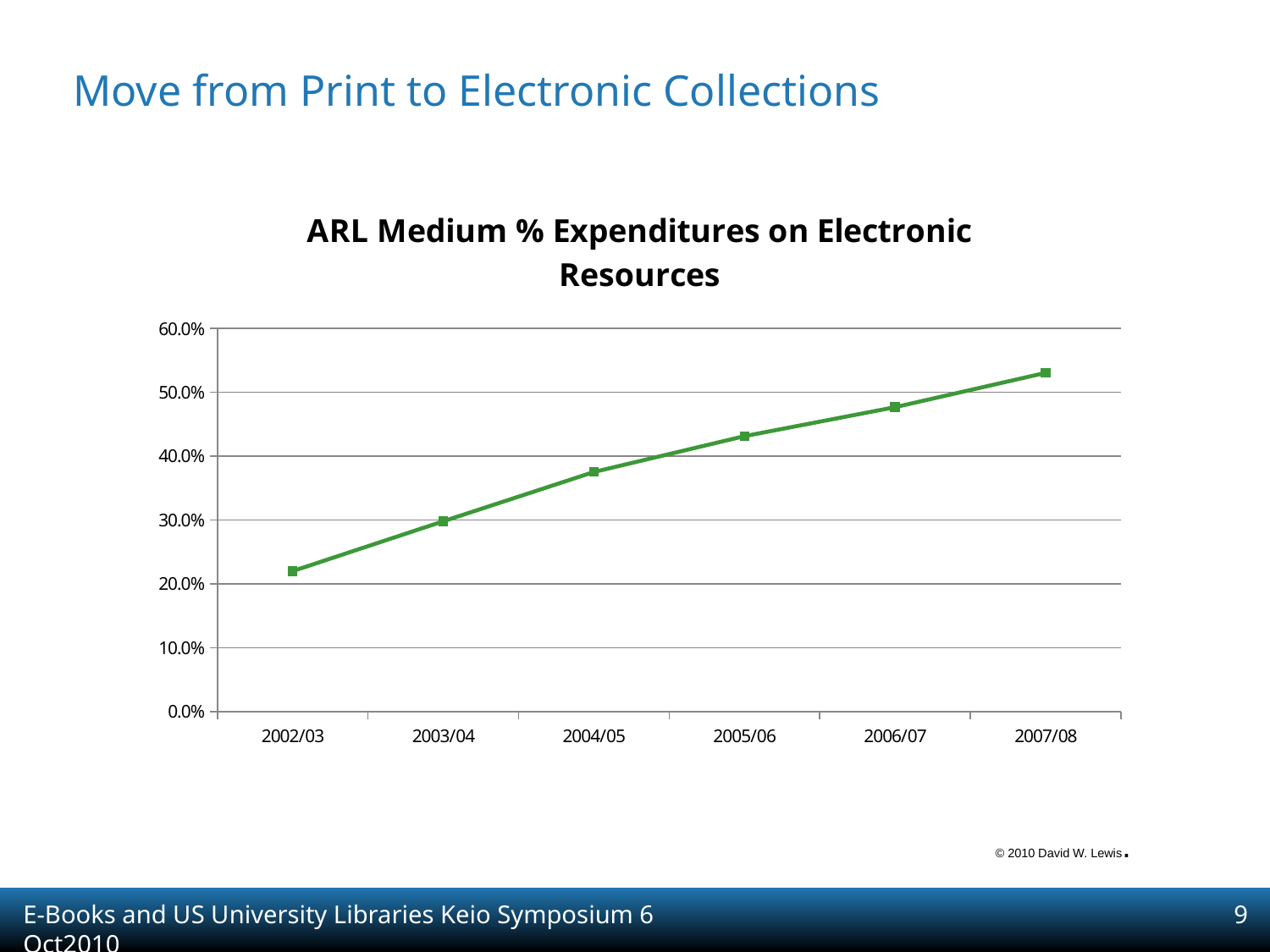
Do the values rise or fall from 2002/03 to 2007/08? rise What is the title of the chart? ARL Medium % Expenditures on Electronic Resources Which year has the lowest value in the chart? 2002/03 Is the value for 2004/05 greater or less than 40.0%? less Which year has the highest value in the chart? 2007/08 How many years are plotted on the x axis of the chart? 6 Which is larger, the value for 2003/04 or the value for 2006/07? 2006/07 Is the value for 2002/03 greater or less than 20.0%? greater Is the value for 2007/08 greater or less than 50.0%? greater What kind of chart is shown on the slide? line chart